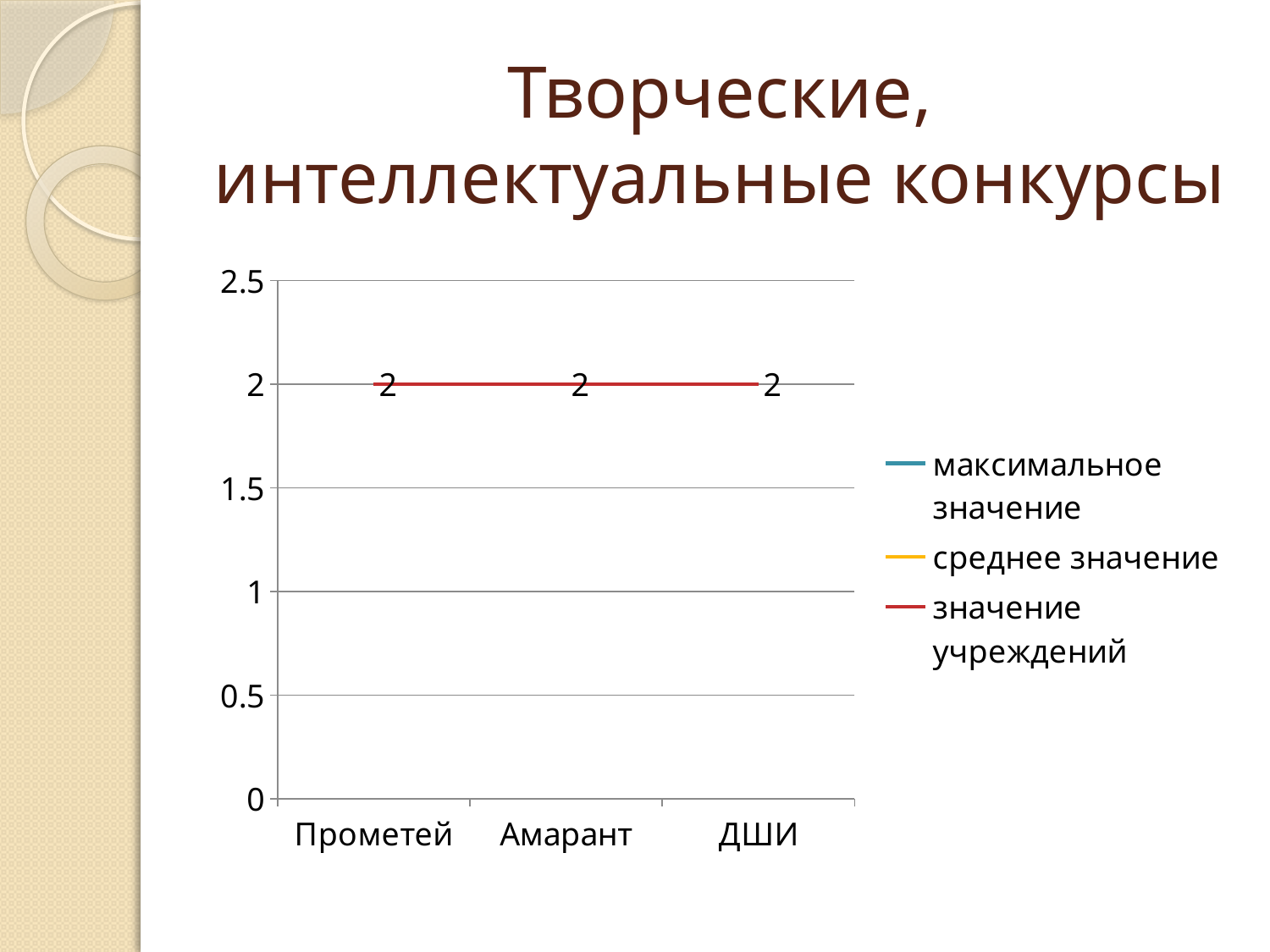
What is the value for Амарант in the series 'значение учреждений'? 2 What is the value for Прометей in the series 'значение учреждений'? 2 Is the value for Амарант in the series 'значение учреждений' greater or less than 1.5? greater How many series does the chart's legend list? 3 Do the values of the 'значение учреждений' line rise, fall or stay the same from Прометей to ДШИ? stay the same What colour is the line for the series 'значение учреждений' in the legend? red What is the title of the slide containing the chart? Творческие, интеллектуальные конкурсы What is the difference between the values for Прометей and ДШИ in the series 'значение учреждений'? 0 What is the value for ДШИ in the series 'значение учреждений'? 2 What kind of chart is shown on the slide? line chart How many categories are shown on the x axis of the chart? 3